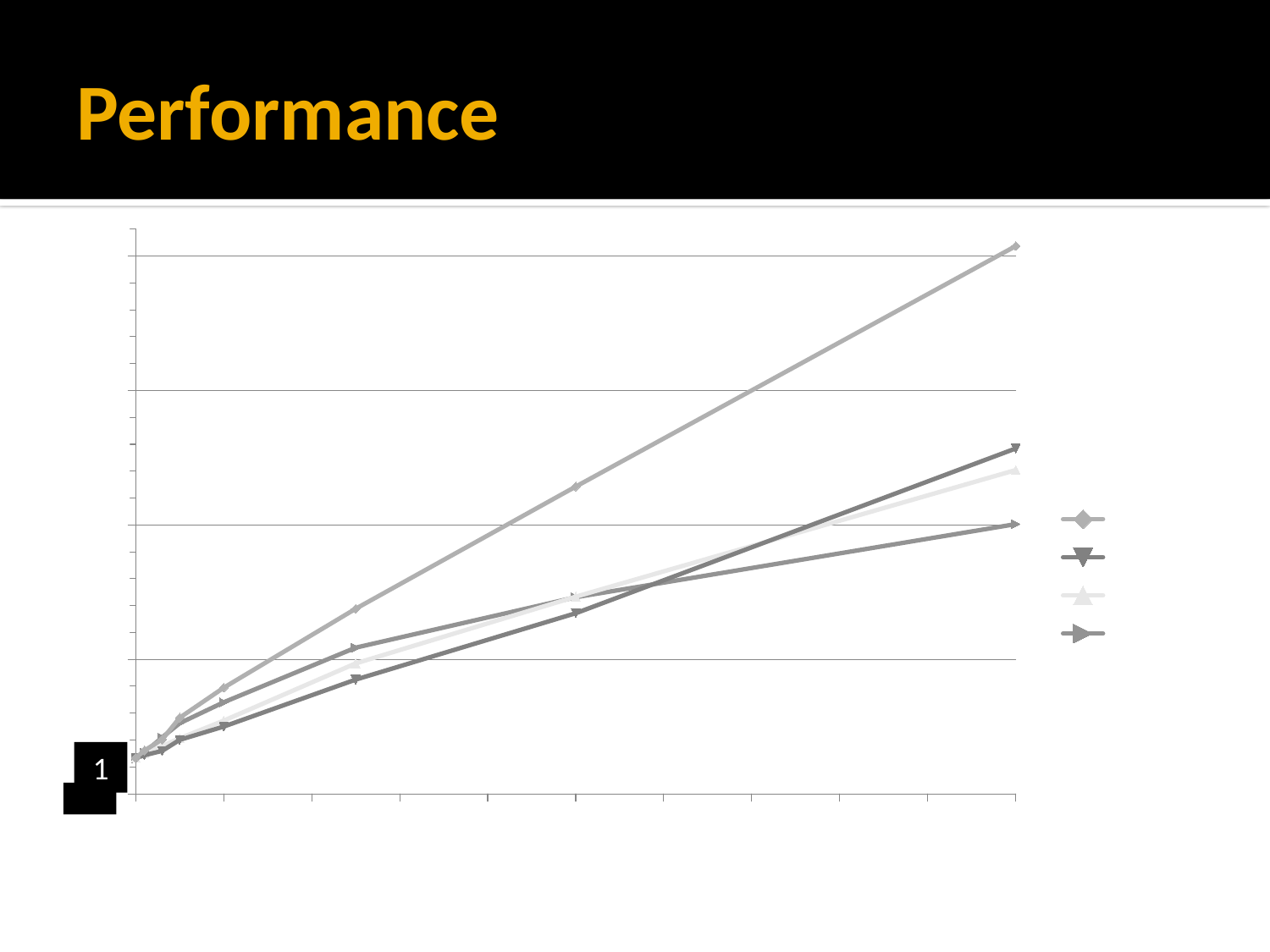
How many series does the chart's legend list? 4 Which series, identified by its legend marker, has the lowest value at the right end of the chart? the right-pointing-triangle-marker series Which series, identified by its legend marker, reaches the highest value at the right end of the chart? the diamond-marker series What is the title shown at the top of the slide? Performance What kind of chart is shown on the slide? line chart Do the plotted values generally rise or fall from left to right along the x axis? rise Where is the legend positioned relative to the plot area? to the right